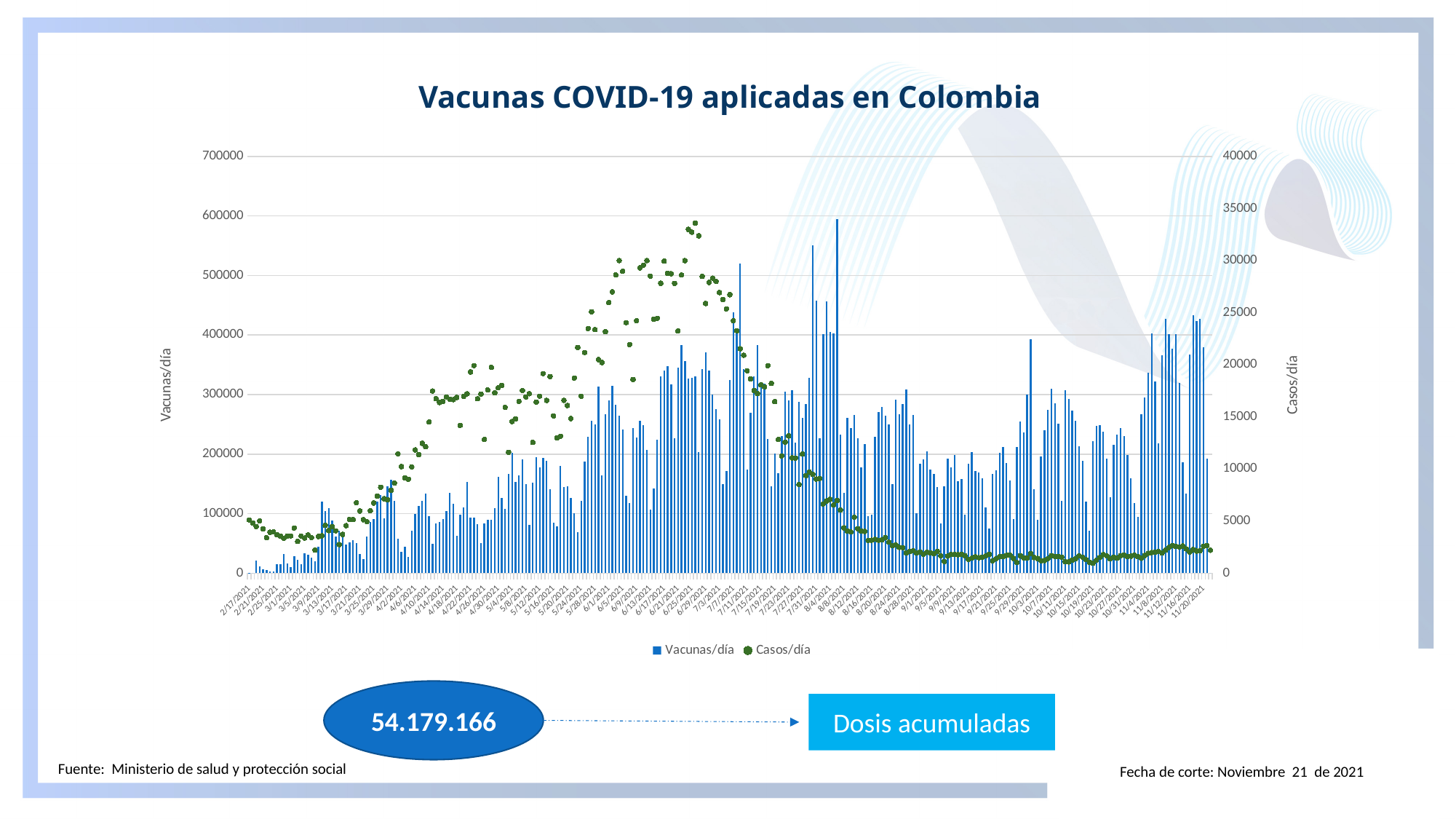
What are the two series named in the legend? Vacunas/día and Casos/día Is the highest Casos/día point greater or less than 30000? greater Do the Casos/día values rise or fall between late June 2021 and September 2021? fall Are the Casos/día values at the end of the period (November 2021) greater or less than 5000? less How many series does the chart legend list? 2 What is the maximum value shown on the right vertical axis? 40000 What is the maximum value shown on the left vertical axis? 700000 What is the title of the left vertical axis? Vacunas/día What is the title of the right vertical axis? Casos/día Is the highest Vacunas/día bar greater or less than 500000? greater What is the first date shown on the x axis? 2/17/2021 What is the title of the chart? Vacunas COVID-19 aplicadas en Colombia